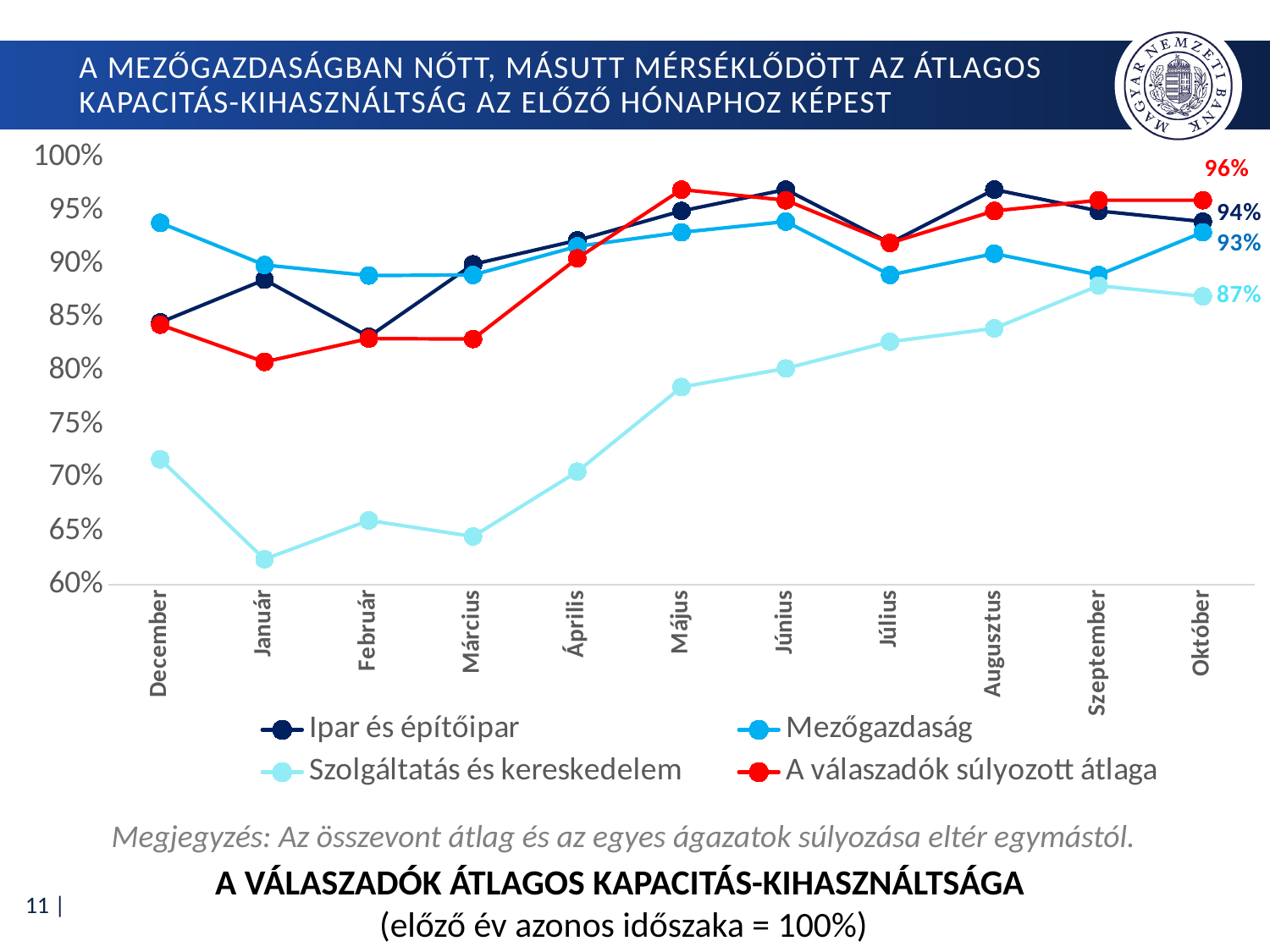
What is the value for A válaszadók súlyozott átlaga in Október? 96% How many months are shown on the x axis? 11 How many series does the legend list? 4 Which series has the lowest value in Október? Szolgáltatás és kereskedelem Is the value for Szolgáltatás és kereskedelem in Január greater or less than 65%? less What is the value for Szolgáltatás és kereskedelem in Október? 87% What is the value for Mezőgazdaság in Október? 93% What is the value for Ipar és építőipar in Október? 94% What is the difference between A válaszadók súlyozott átlaga and Szolgáltatás és kereskedelem in Október? 9 percentage points What kind of chart is shown on the slide? Line chart In Október, which is larger: Ipar és építőipar or Mezőgazdaság? Ipar és építőipar Is the value for Mezőgazdaság in December greater or less than 90%? greater